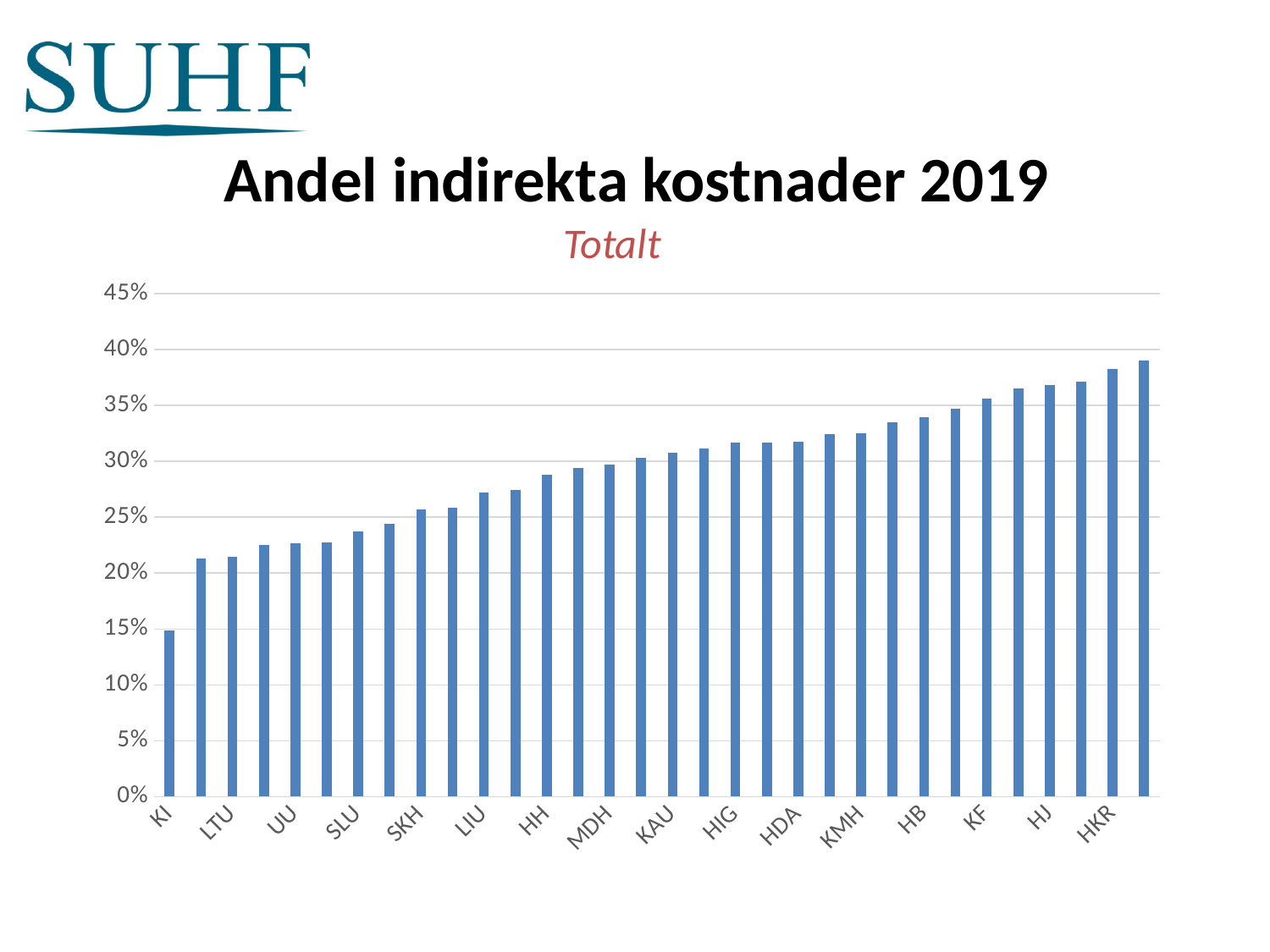
How many category labels are shown on the x axis? 16 Is the value for HB greater or less than 30%? greater What colour are the bars in the chart? blue Is the value for HKR greater or less than 35%? greater Is the value for KI greater or less than 20%? less Which labelled category has the lowest value? KI Which has the larger value, HJ or LIU? HJ Do the values rise or fall from left to right along the x axis? rise What is the title printed directly above the chart? Totalt What kind of chart is shown on the slide? bar chart